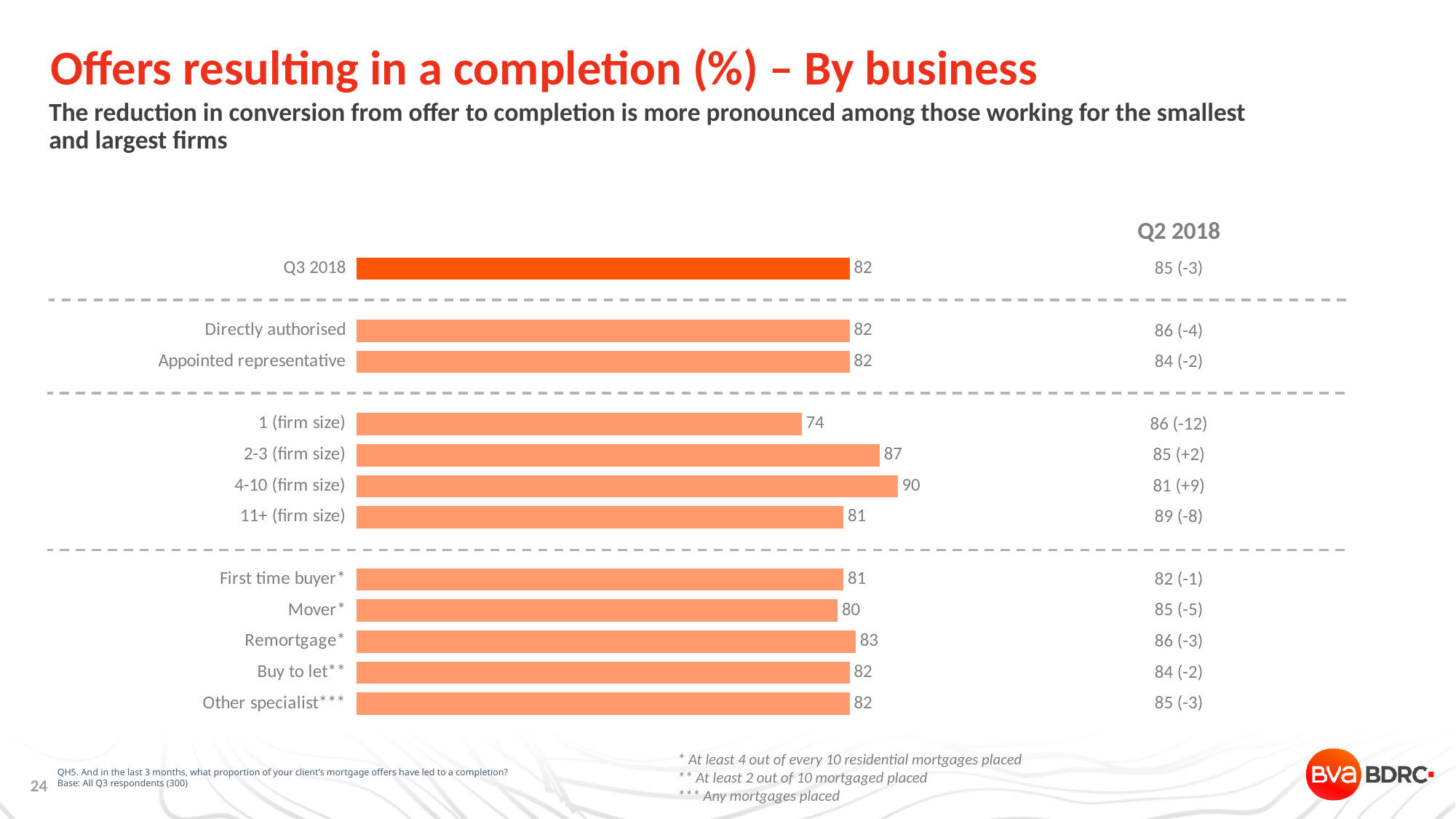
Which is larger, the value for 2-3 (firm size) or the value for 11+ (firm size)? 2-3 (firm size) Which category has the lowest value? 1 (firm size) Which category has the highest value? 4-10 (firm size) Which bar is drawn in a darker orange than the others? Q3 2018 What is the value for Remortgage? 83 What is the value for 1 (firm size)? 74 What kind of chart is shown on the slide? Bar chart How many bars are plotted in the chart? 12 What is the value for 4-10 (firm size)? 90 What is the value for Mover? 80 What Q2 2018 value is shown for 11+ (firm size)? 89 (-8) What is the difference between the values for 4-10 (firm size) and 1 (firm size)? 16